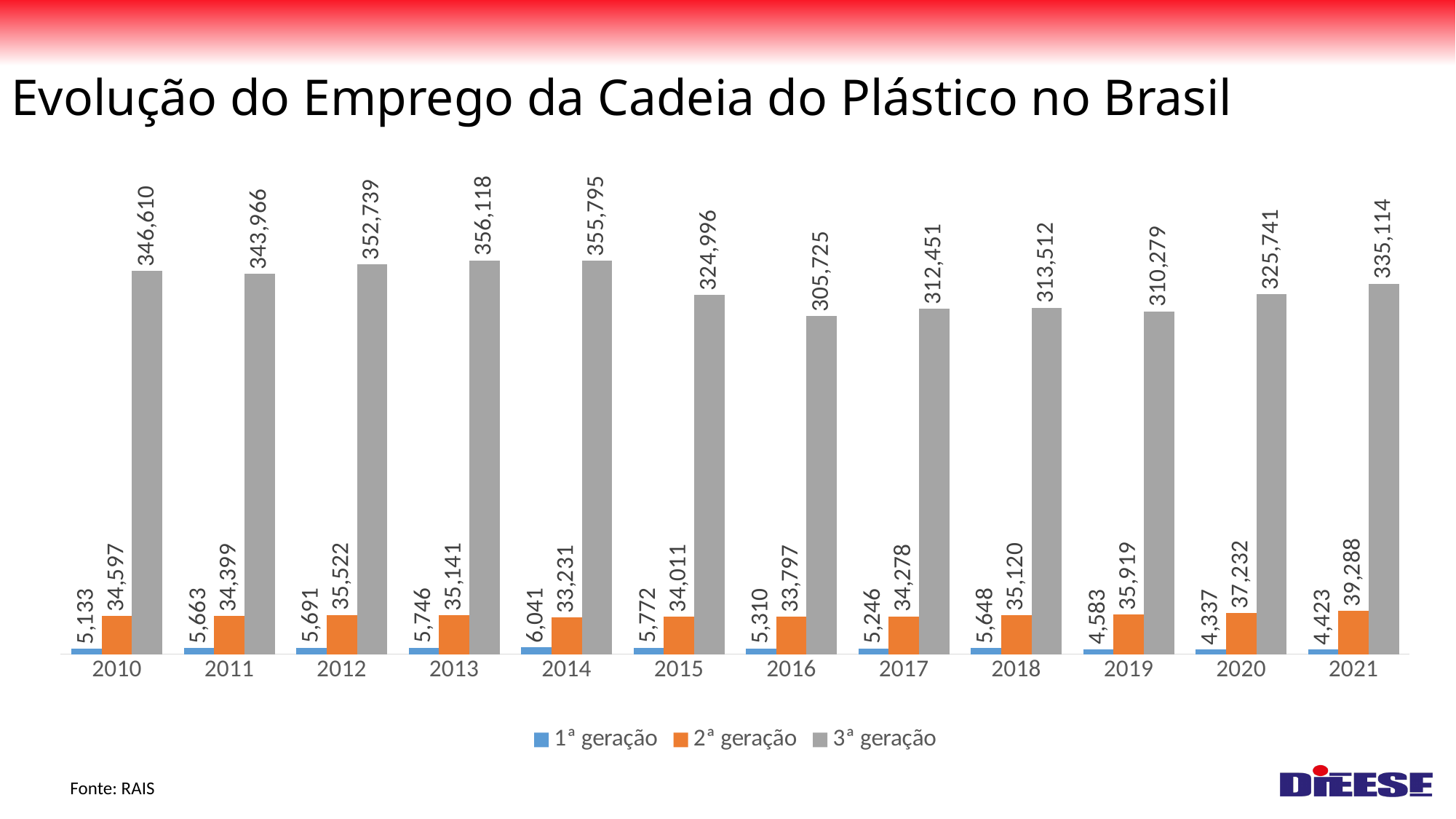
What is the value for 3ª geração in 2013? 356,118 What kind of chart is shown on the slide? Bar chart What is the value for 1ª geração in 2010? 5,133 In which year is the 2ª geração value the lowest? 2014 In which year is the 3ª geração value the highest? 2013 What is the difference between the 3ª geração values for 2021 and 2020? 9,373 Which is larger, the 2ª geração value in 2019 or in 2018? 2019 How many series does the legend list? 3 In which year is the 3ª geração value the lowest? 2016 In which year is the 1ª geração value the highest? 2014 What is the value for 2ª geração in 2021? 39,288 How many years are shown on the x axis? 12